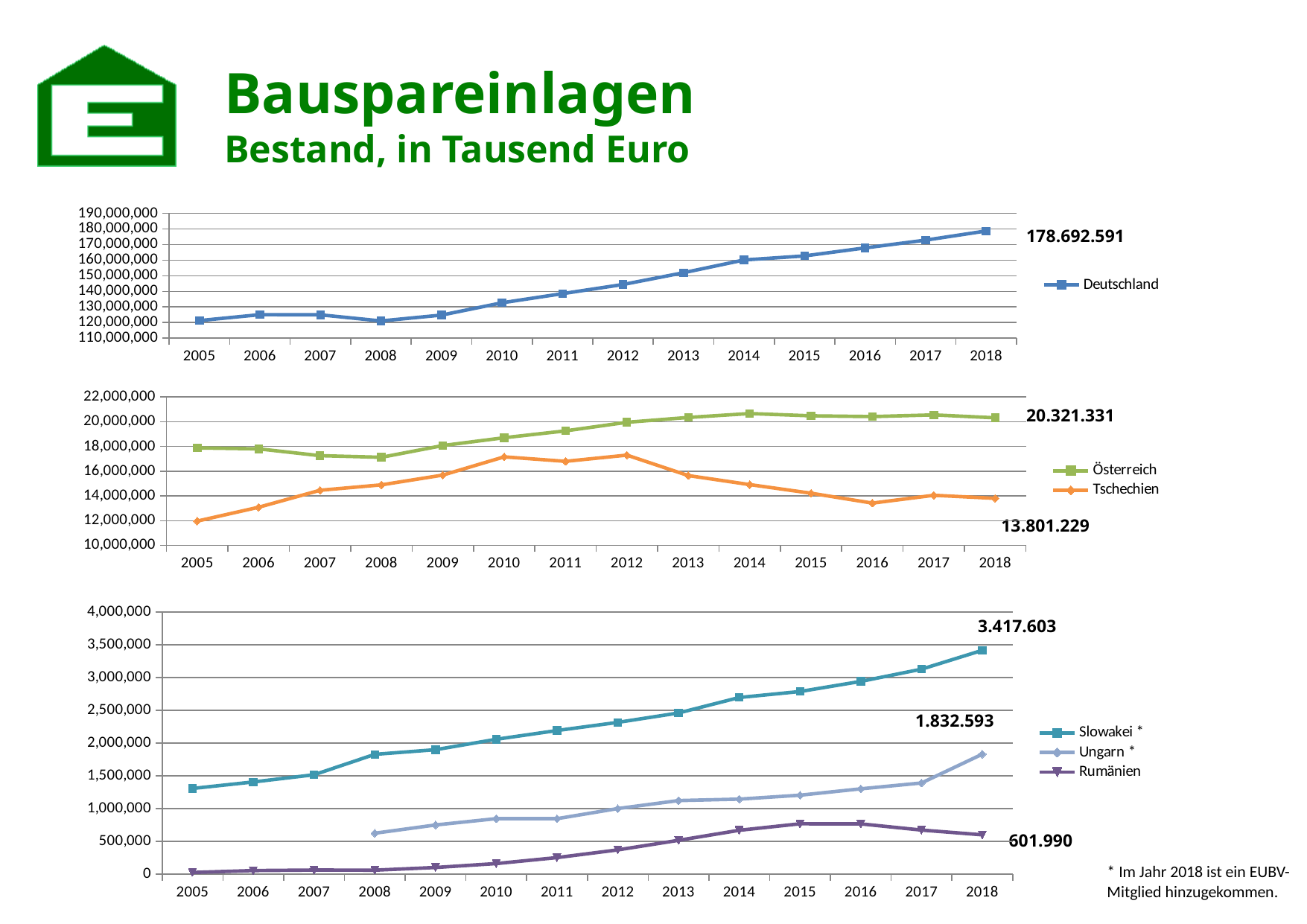
What kind of chart is the top chart? line chart On the middle chart, what is the value for Österreich in 2018? 20.321.331 On the middle chart, which series has the lower value in 2018, Österreich or Tschechien? Tschechien On the bottom chart, what is the value for Rumänien in 2018? 601.990 On the bottom chart, how many series does the legend list? 3 On the top chart, is the value for Deutschland in 2010 greater or less than 130,000,000? greater On the bottom chart, what is the value for Ungarn in 2018? 1.832.593 On the middle chart, what is the value for Tschechien in 2018? 13.801.229 On the top chart, what is the value for Deutschland in 2018? 178.692.591 On the bottom chart, what is the value for Slowakei in 2018? 3.417.603 On the middle chart, how many series does the legend list? 2 On the bottom chart, which series has the highest value in 2018? Slowakei